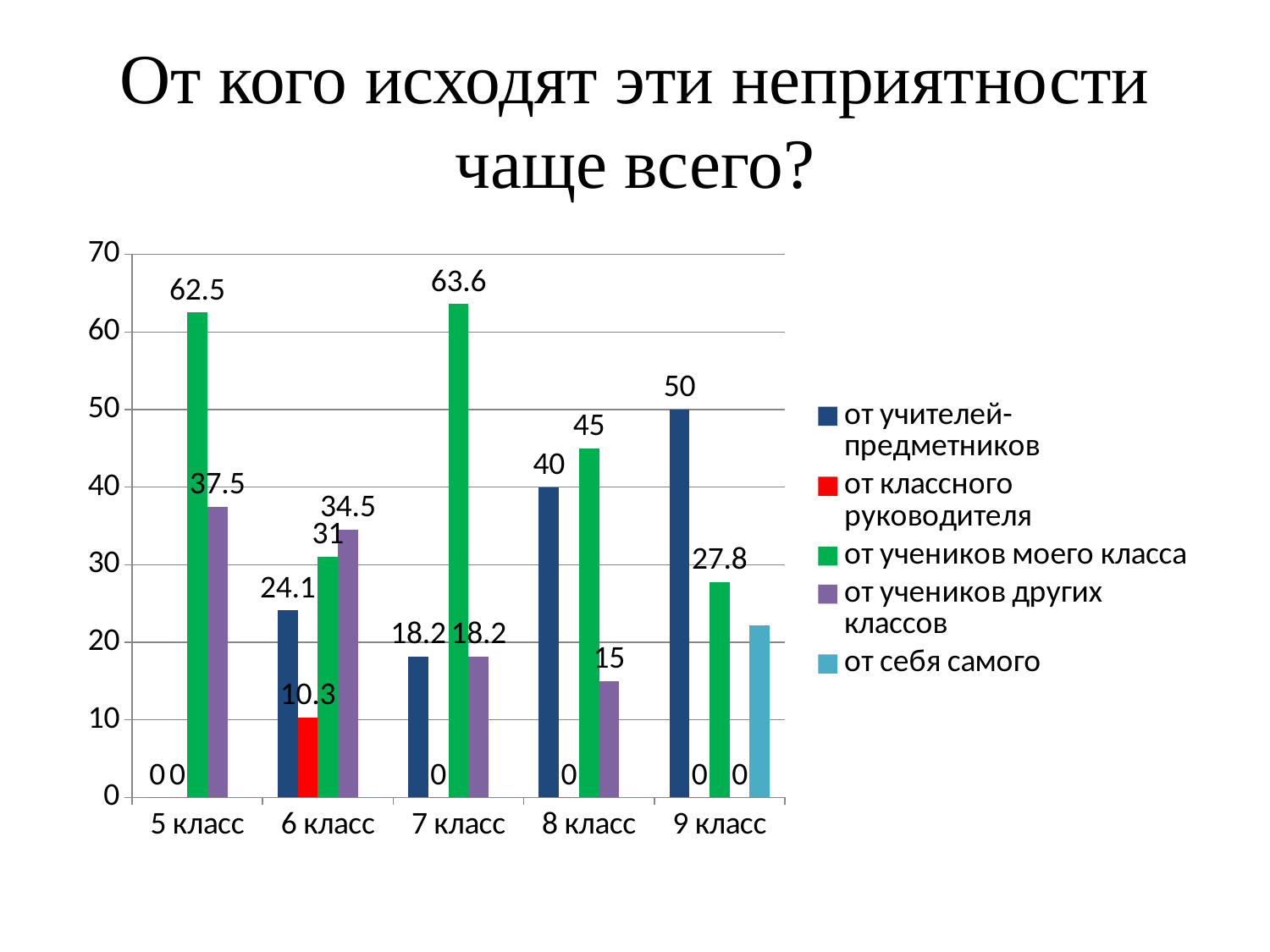
What is the value for «от учеников моего класса» in 5 класс? 62.5 In 6 класс, which is larger: «от учеников других классов» or «от учеников моего класса»? от учеников других классов How many classes (categories) are shown on the x axis? 5 What kind of chart is shown on the slide? bar chart Is the value for «от себя самого» in 9 класс greater or less than 20? greater What is the value for «от учеников других классов» in 8 класс? 15 What is the value for «от учеников моего класса» in 7 класс? 63.6 What is the value for «от учителей-предметников» in 9 класс? 50 In 8 класс, what is the difference between «от учеников моего класса» and «от учителей-предметников»? 5 What is the value for «от классного руководителя» in 6 класс? 10.3 How many series does the legend list? 5 Which class has the highest value for «от учеников моего класса»? 7 класс